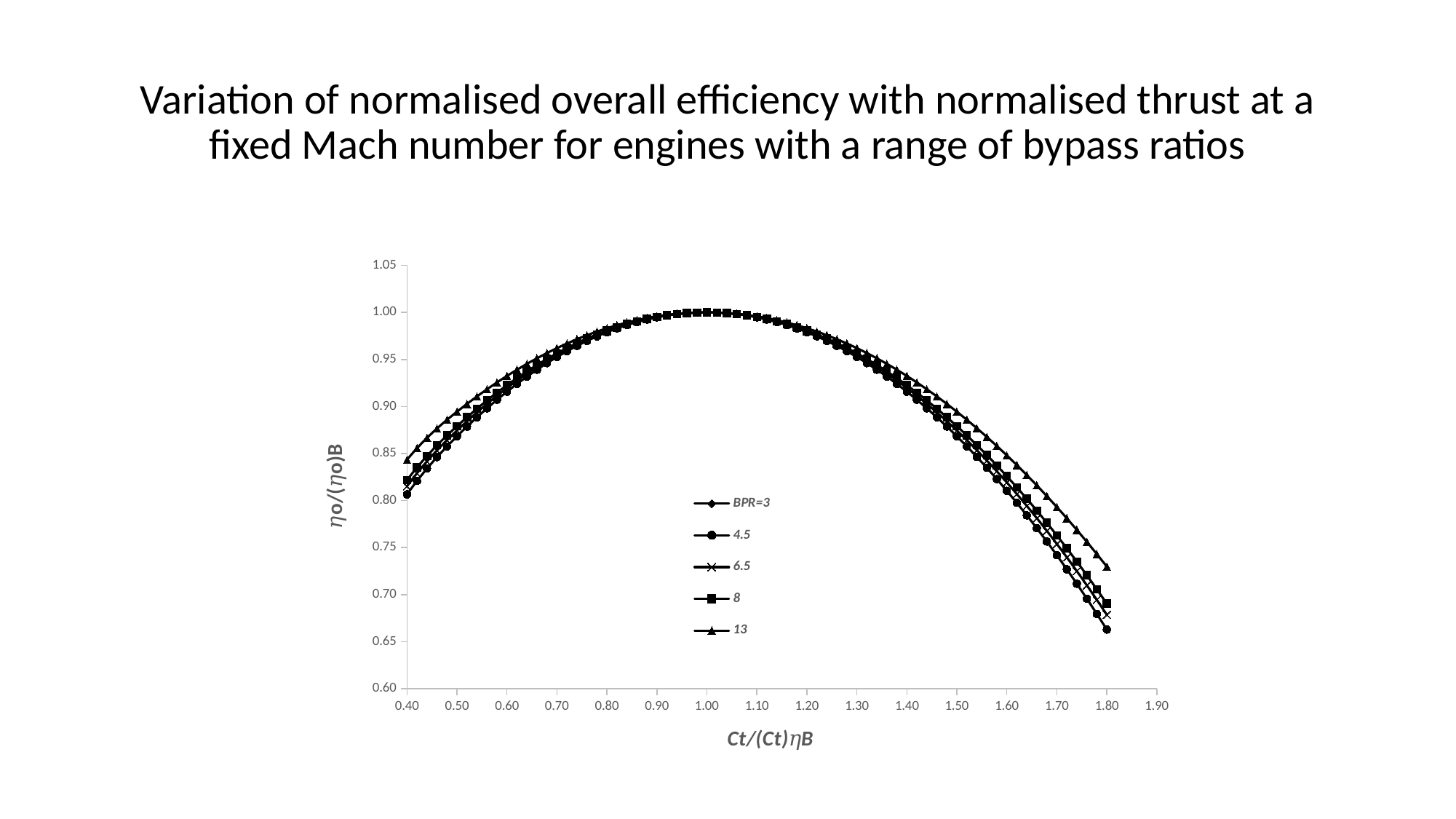
At Ct/(Ct)ηB = 1.80, which is larger: the value for the 13 series or the value for the 4.5 series? 13 What kind of chart is shown on the slide? Line chart At Ct/(Ct)ηB = 1.80, is the value for BPR=13 greater or less than 0.70? greater How many series does the legend list? 5 At Ct/(Ct)ηB = 0.40, is the value for the 13 series greater or less than 0.80? greater Which bypass ratio series has the highest value at Ct/(Ct)ηB = 1.80? 13 Do the values rise or fall as Ct/(Ct)ηB increases from 1.00 to 1.80? fall What value do all the series reach at Ct/(Ct)ηB = 1.00? 1.00 What is the title of the x axis? Ct/(Ct)ηB What is the label of the first series in the legend? BPR=3 At Ct/(Ct)ηB = 1.80, is the value for the 4.5 series greater or less than 0.70? less Which bypass ratio series has the highest value at Ct/(Ct)ηB = 0.40? 13